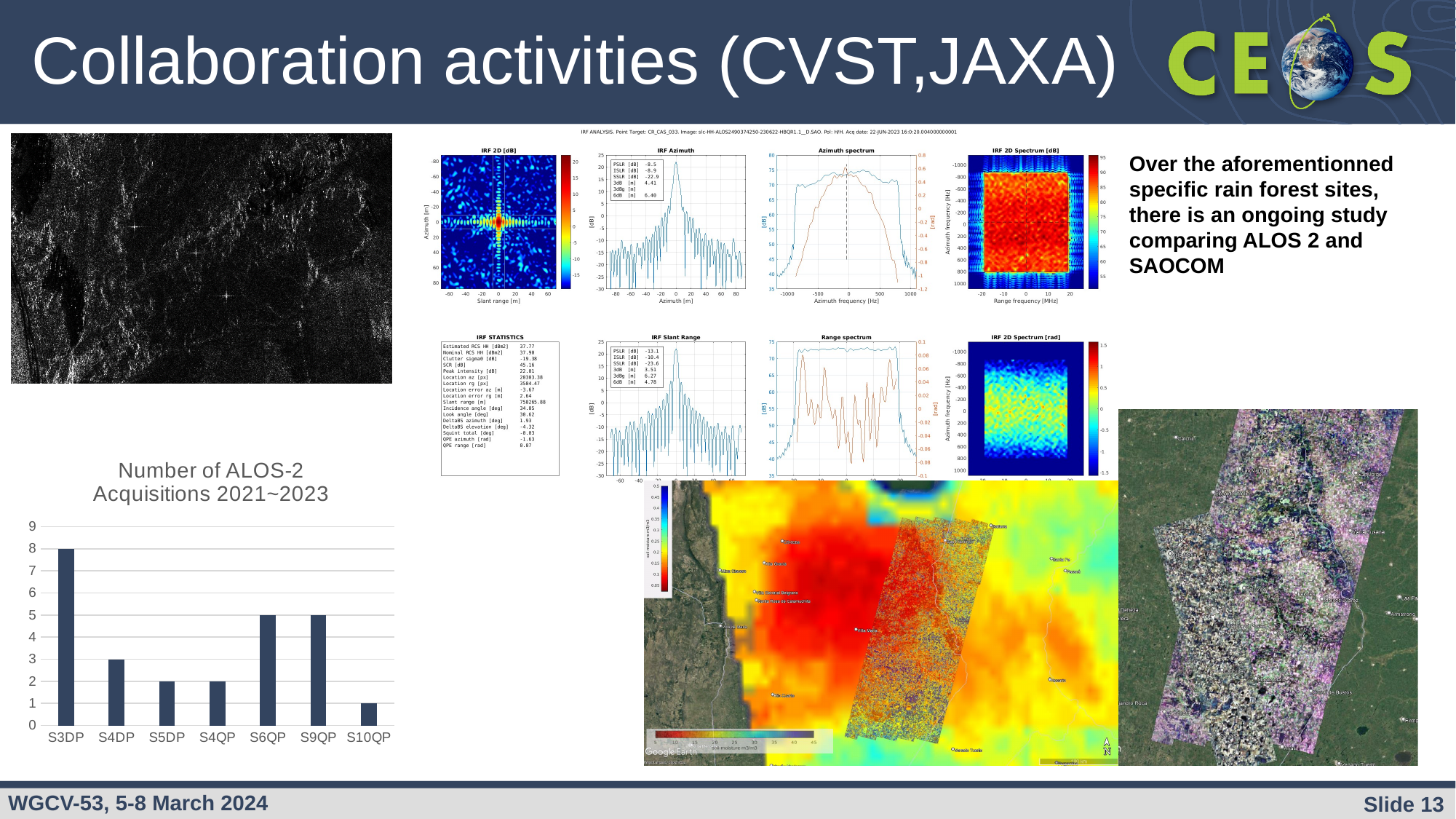
What kind of chart is the 'Number of ALOS-2 Acquisitions 2021~2023' chart? Bar chart In the 'Number of ALOS-2 Acquisitions 2021~2023' chart, which is larger, the value for S4DP or the value for S9QP? S9QP In the 'Number of ALOS-2 Acquisitions 2021~2023' chart, which category has the lowest value? S10QP In the 'Number of ALOS-2 Acquisitions 2021~2023' chart, what is the difference between the values for S3DP and S6QP? 3 In the 'Number of ALOS-2 Acquisitions 2021~2023' chart, which category has the highest value? S3DP How many categories are shown in the 'Number of ALOS-2 Acquisitions 2021~2023' chart? 7 In the 'Number of ALOS-2 Acquisitions 2021~2023' chart, what is the value for S3DP? 8 In the 'Number of ALOS-2 Acquisitions 2021~2023' chart, is the value for S3DP greater or less than 5? greater What is the title of the bar chart in the lower left of the slide? Number of ALOS-2 Acquisitions 2021~2023 In the 'Number of ALOS-2 Acquisitions 2021~2023' chart, what is the value for S10QP? 1 In the 'Number of ALOS-2 Acquisitions 2021~2023' chart, what is the value for S4DP? 3 In the 'Number of ALOS-2 Acquisitions 2021~2023' chart, what is the value for S5DP? 2